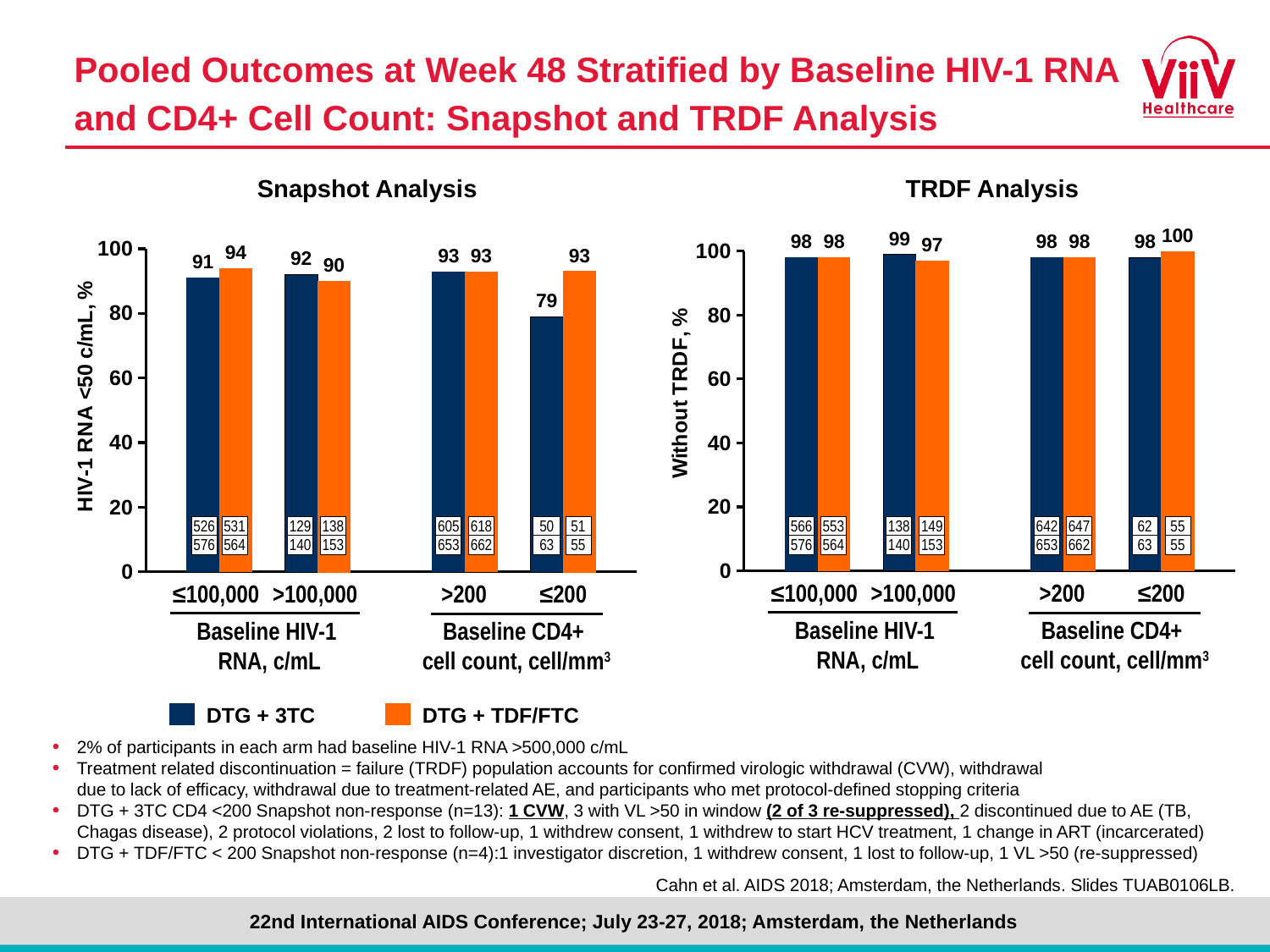
In the Snapshot Analysis chart, what is the difference between DTG + TDF/FTC and DTG + 3TC in the baseline CD4+ cell count ≤200 category? 14 How many series does the legend list for the charts? 2 In the TRDF Analysis chart, what is the difference between DTG + 3TC and DTG + TDF/FTC in the baseline HIV-1 RNA >100,000 category? 2 What kind of chart is the TRDF Analysis chart? Bar chart In the TRDF Analysis chart, what is the value for DTG + 3TC in the baseline HIV-1 RNA >100,000 category? 99 In the Snapshot Analysis chart, which is larger in the baseline HIV-1 RNA >100,000 category: DTG + 3TC or DTG + TDF/FTC? DTG + 3TC What is the y-axis label of the TRDF Analysis chart? Without TRDF, % In the Snapshot Analysis chart, is the value for DTG + 3TC in the baseline CD4+ cell count ≤200 category greater or less than 80? less In the Snapshot Analysis chart, which category has the lowest value for DTG + 3TC? ≤200 (Baseline CD4+ cell count) In the Snapshot Analysis chart, what is the value for DTG + 3TC in the baseline CD4+ cell count ≤200 category? 79 In the TRDF Analysis chart, what is the value for DTG + TDF/FTC in the baseline CD4+ cell count ≤200 category? 100 In the Snapshot Analysis chart, what is the value for DTG + TDF/FTC in the baseline HIV-1 RNA ≤100,000 category? 94